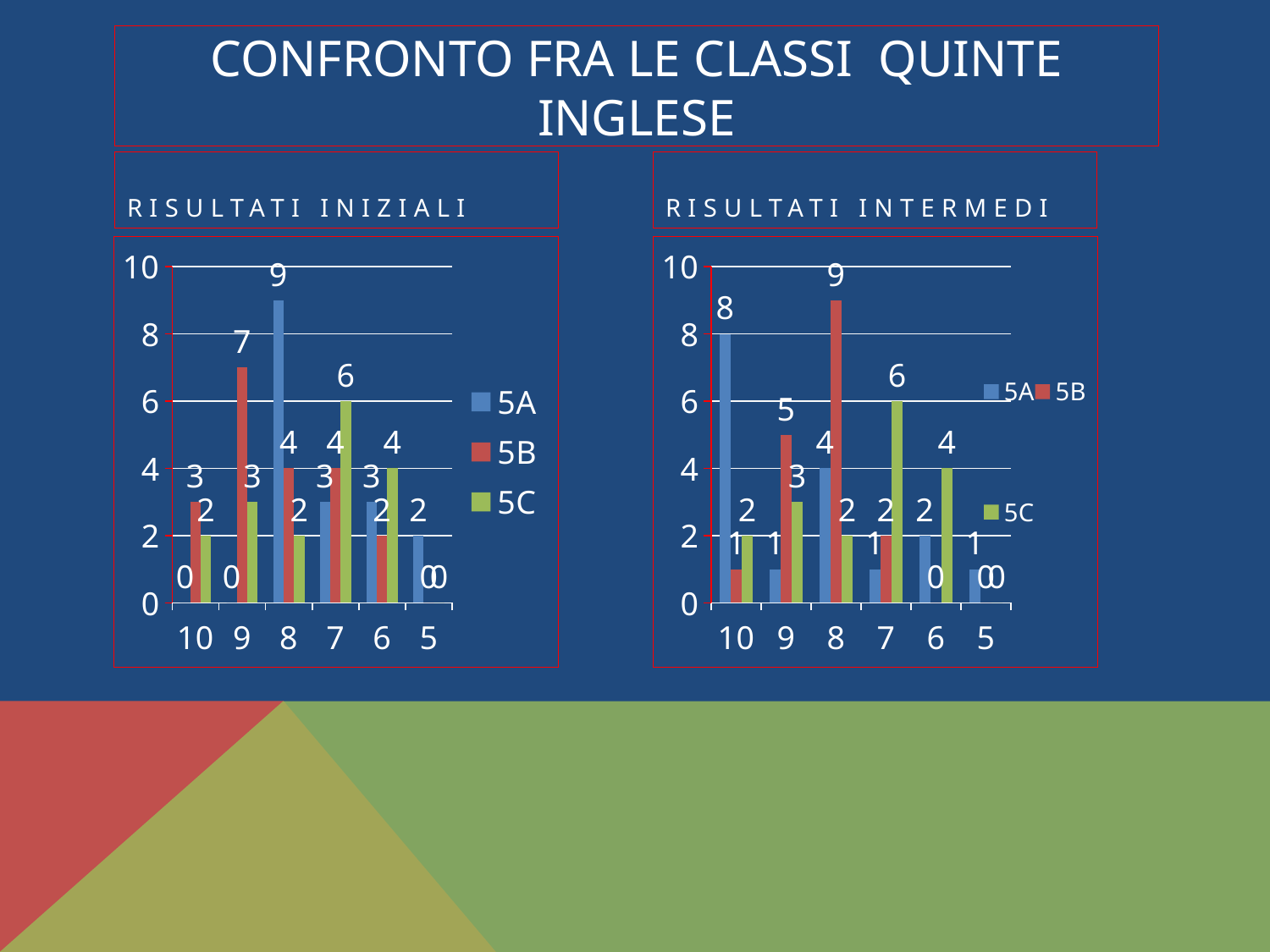
What kind of chart is the RISULTATI INTERMEDI chart? Bar chart In the RISULTATI INTERMEDI chart, what is the value for 5A at category 10? 8 In the RISULTATI INTERMEDI chart, what is the difference between the 5B value and the 5A value at category 8? 5 How many series does the legend of the RISULTATI INIZIALI chart list? 3 In the RISULTATI INTERMEDI chart, what is the value for 5B at category 8? 9 In the RISULTATI INIZIALI chart, which is larger at category 9: the value for 5B or the value for 5C? 5B In the RISULTATI INIZIALI chart, which category has the highest value for 5A? 8 In the RISULTATI INIZIALI chart, what is the value for 5A at category 8? 9 In the RISULTATI INIZIALI chart, what is the value for 5B at category 9? 7 In the RISULTATI INTERMEDI chart, which category has the highest value for 5C? 7 How many categories are shown on the x axis of the RISULTATI INTERMEDI chart? 6 In the RISULTATI INIZIALI chart, what is the value for 5C at category 7? 6